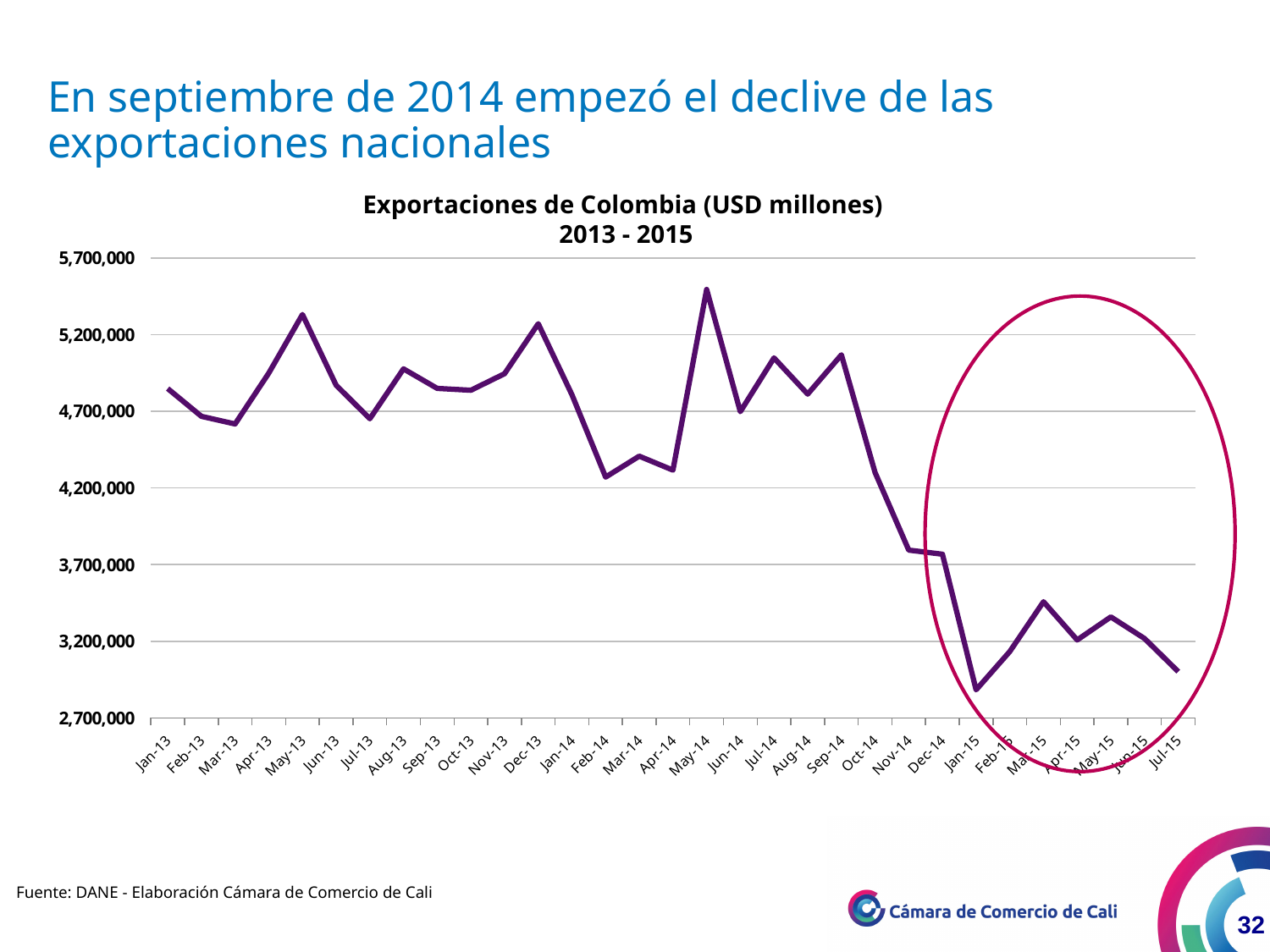
How many monthly data points are plotted on the chart? 31 What kind of chart is shown on the slide? Line chart Is the value for Jan-15 greater or less than 3,200,000? less Which month has the highest export value on the chart? May-14 Is the value for Nov-14 greater or less than 4,200,000? less What is the title of the chart? Exportaciones de Colombia (USD millones) 2013 - 2015 Overall, do export values rise or fall from Jan-13 to Jul-15? Fall Is the value for Feb-14 greater or less than 4,700,000? less Which is larger, the value for Jan-13 or the value for Jul-15? Jan-13 Which month has the lowest export value on the chart? Jan-15